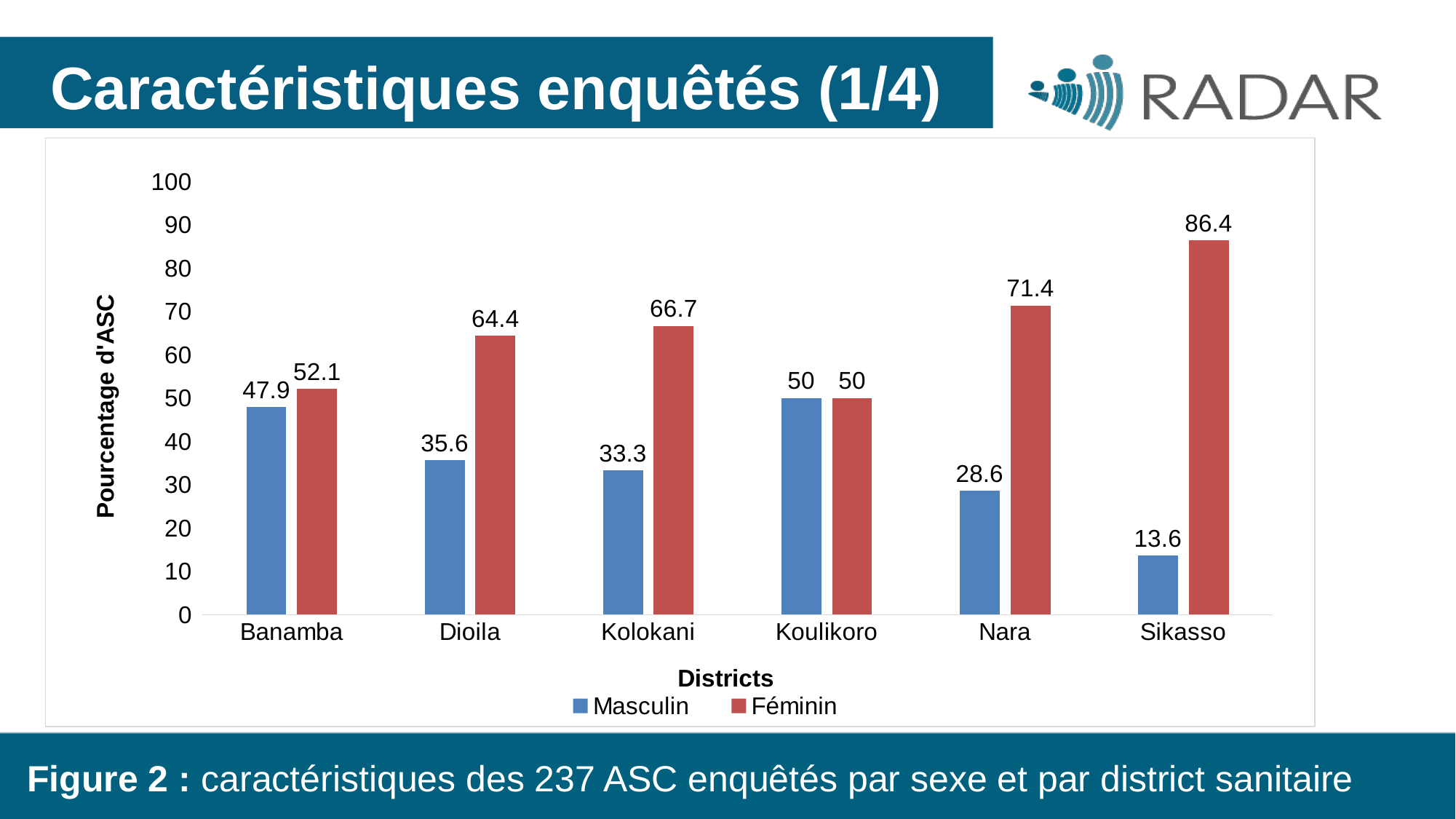
How many series does the legend list? 2 Which district has the highest Féminin value? Sikasso What is the label of the y axis? Pourcentage d'ASC What kind of chart is shown on the slide? bar chart What is the Masculin value for Nara? 28.6 What is the Masculin value for Dioila? 35.6 Is the Féminin value for Nara greater or less than 70? greater What is the difference between the Féminin and Masculin values for Kolokani? 33.4 How many districts are shown on the x axis? 6 What is the Féminin value for Sikasso? 86.4 Which district has the lowest Masculin value? Sikasso Which is larger for Banamba, the Masculin value or the Féminin value? Féminin